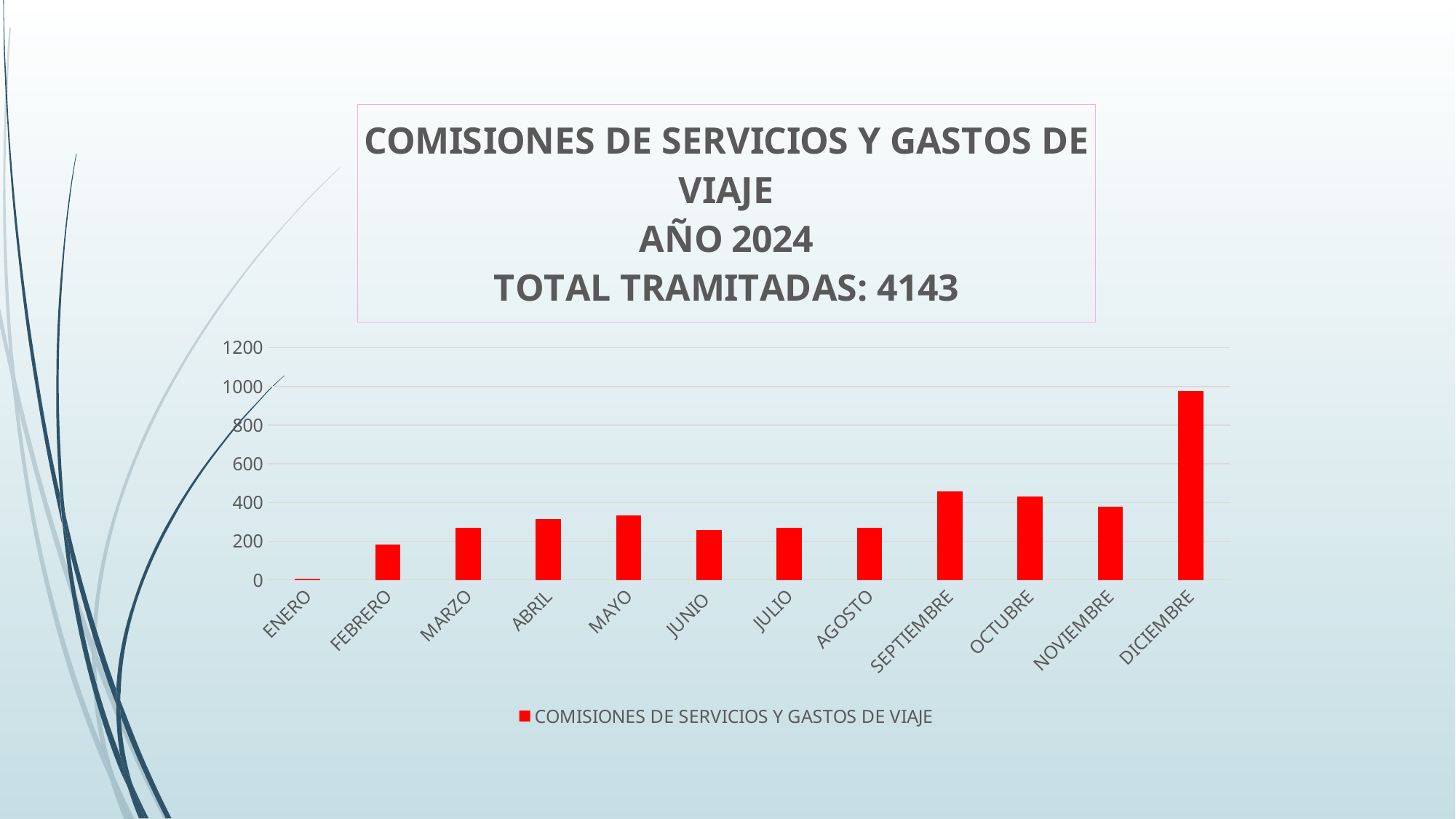
Is the value for MAYO greater or less than 400? less Is the value for DICIEMBRE greater or less than 800? greater Which month has the lowest value in the chart? ENERO How many months are shown on the x axis of the chart? 12 What kind of chart is shown on the slide? bar chart Is the value for SEPTIEMBRE greater or less than 400? greater Which month has the highest value in the chart? DICIEMBRE According to the chart title, what is the total number of tramitadas for 2024? 4143 Which is larger, the value for NOVIEMBRE or the value for MAYO? NOVIEMBRE Which is larger, the value for SEPTIEMBRE or the value for FEBRERO? SEPTIEMBRE How many series does the legend list? 1